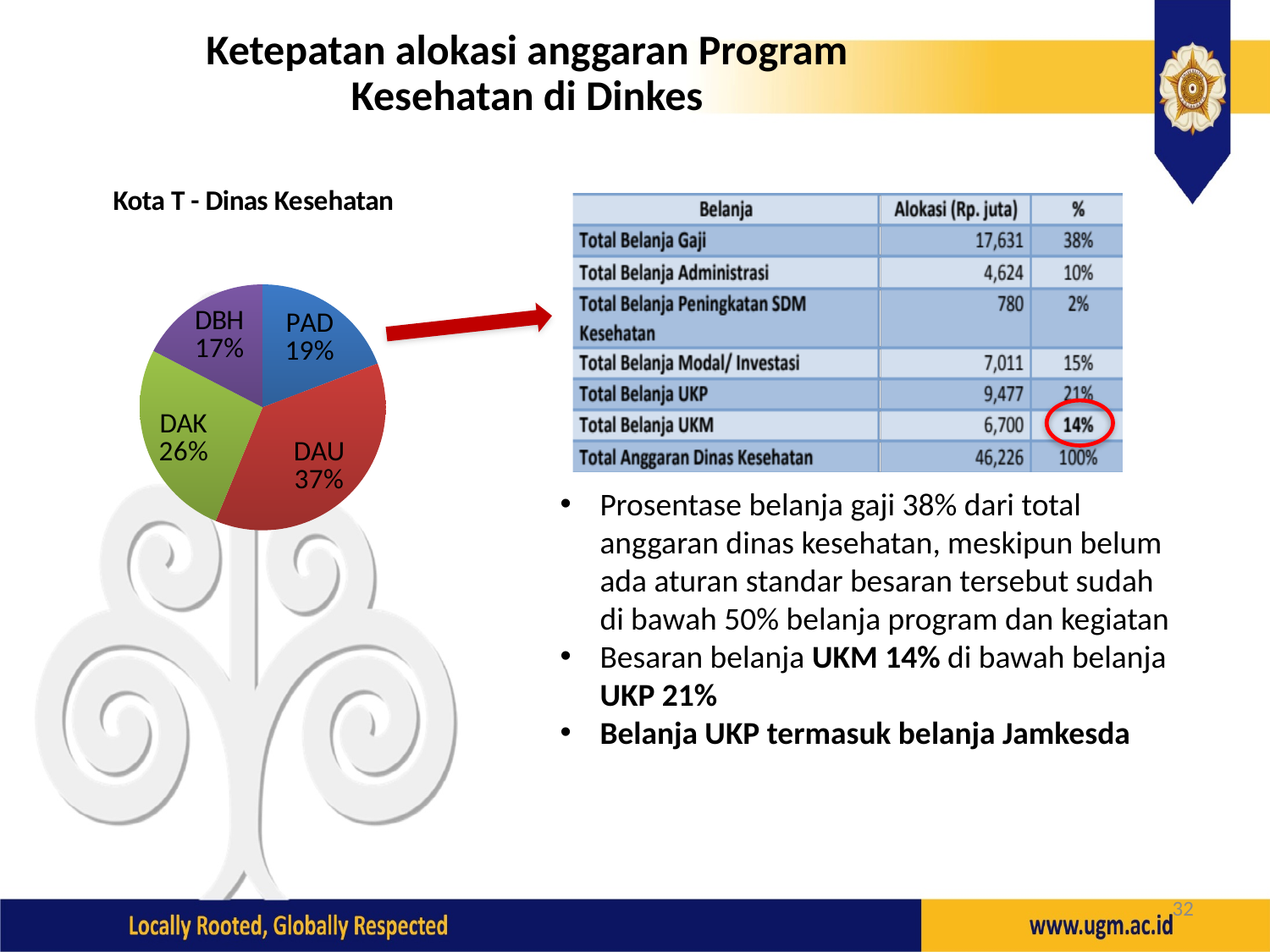
How many slices does the pie chart have? 4 What is the title of the pie chart? Kota T - Dinas Kesehatan Which is larger in the pie chart, PAD or DAK? DAK Which slice of the pie chart is the smallest? DBH What is the share of DBH in the pie chart? 17% Which slice of the pie chart is the largest? DAU What is the share of DAK in the pie chart? 26% What type of chart is shown under the title "Kota T - Dinas Kesehatan"? Pie chart What is the difference in percentage points between the DAU and DAK slices? 11 What is the difference in percentage points between the PAD and DBH slices? 2 What is the share of DAU in the pie chart? 37% What is the share of PAD in the pie chart? 19%